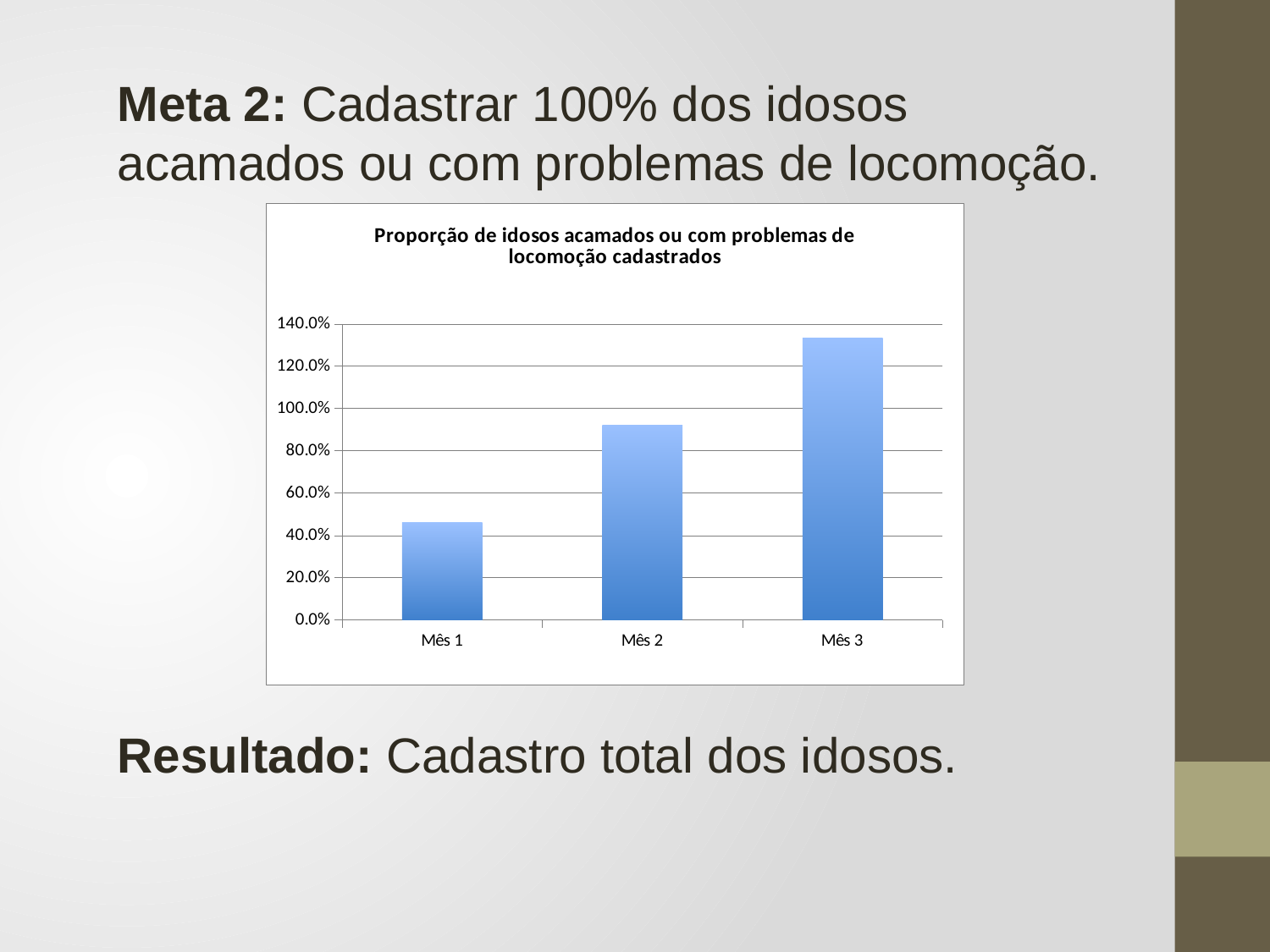
How many categories are shown on the x axis of the chart? 3 Is the value for Mês 3 greater or less than 120.0%? greater What kind of chart is shown on the slide? bar chart Is the value for Mês 1 greater or less than 40.0%? greater Which is larger, the value for Mês 2 or the value for Mês 3? Mês 3 Is the value for Mês 2 greater or less than 80.0%? greater Do the values rise or fall from Mês 1 to Mês 3? rise Which month has the highest value in the chart? Mês 3 What is the title of the chart? Proporção de idosos acamados ou com problemas de locomoção cadastrados Which month has the lowest value in the chart? Mês 1